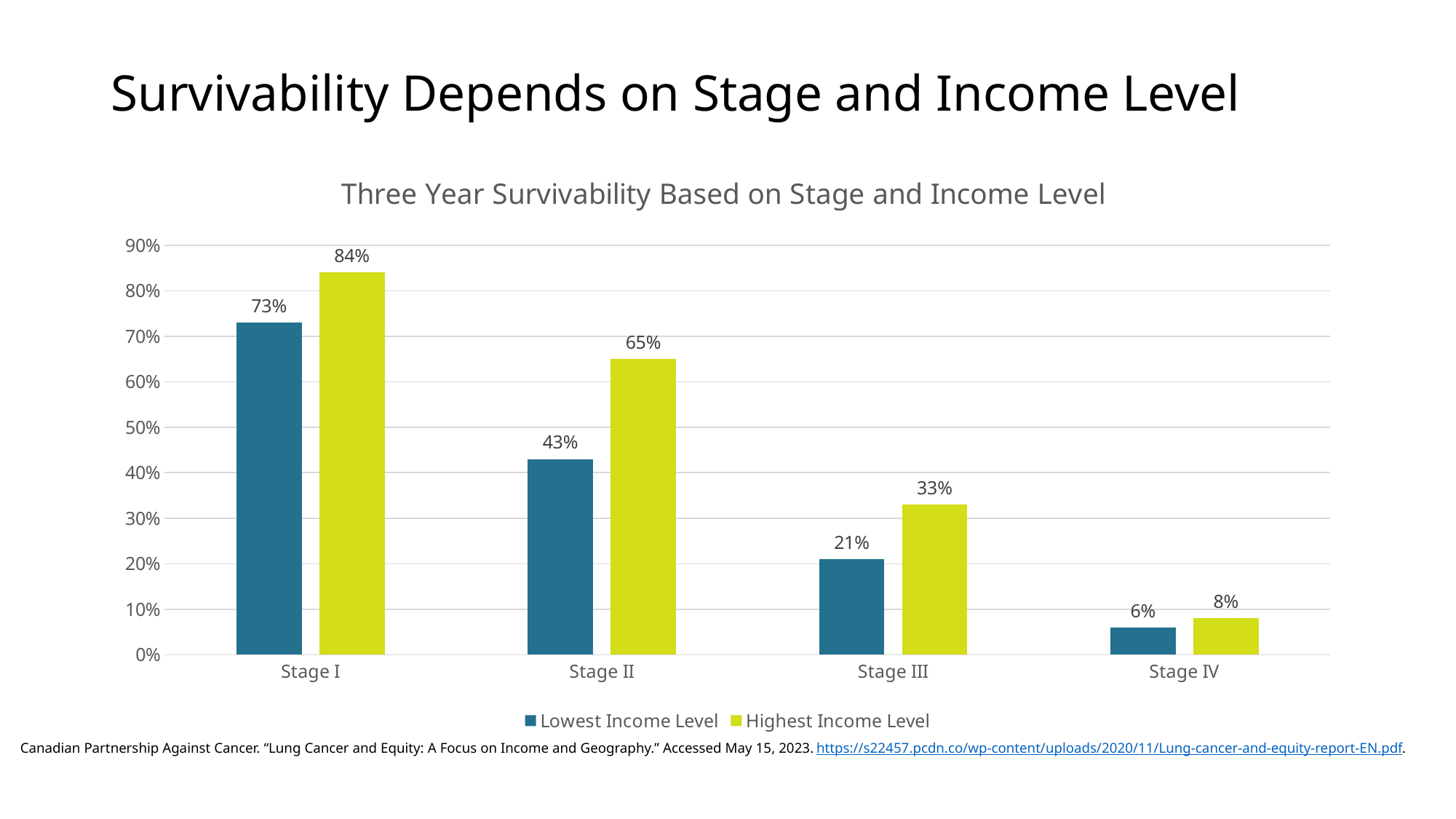
What kind of chart is shown on the slide? Bar chart How many series does the legend list? 2 Which stage has the lowest survivability for the Lowest Income Level? Stage IV Which stage has the highest survivability for the Highest Income Level? Stage I What is the three year survivability for the Highest Income Level at Stage II? 65% What is the value for the Highest Income Level at Stage IV? 8% What is the three year survivability for the Lowest Income Level at Stage I? 73% What is the difference between the Highest Income Level and Lowest Income Level values at Stage II? 22% What is the difference between the Highest Income Level and Lowest Income Level values at Stage III? 12% How many stages are shown on the x axis? 4 Do the Lowest Income Level values rise or fall from Stage I to Stage IV? Fall At Stage I, which income level has the higher survivability? Highest Income Level